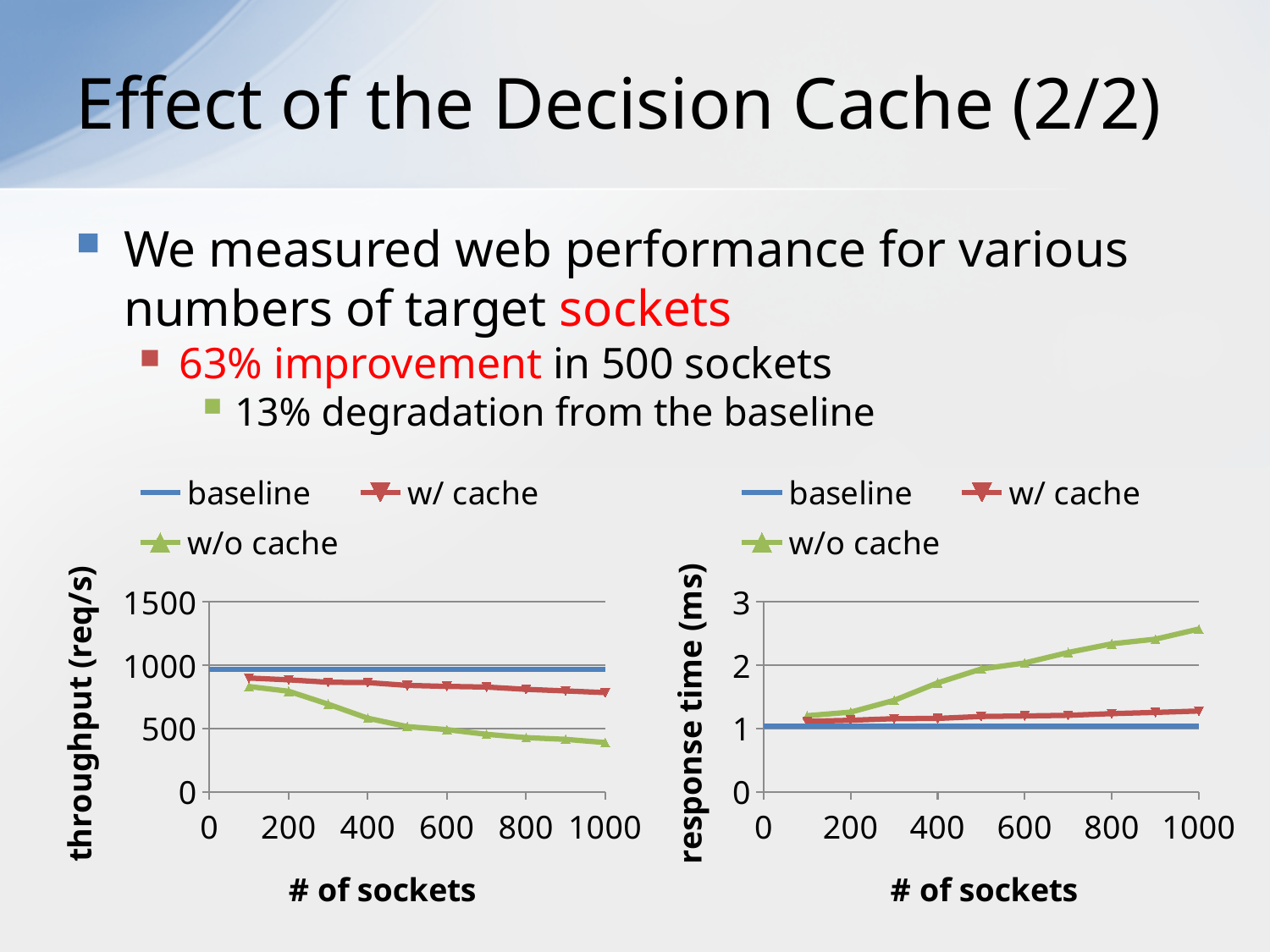
In the throughput (req/s) chart on the left, which series has the higher value at 1000 sockets, w/ cache or w/o cache? w/ cache In the throughput (req/s) chart on the left, is the w/o cache value at 1000 sockets greater or less than 500? less In the response time (ms) chart on the right, which series has the higher value at 800 sockets, w/o cache or baseline? w/o cache What kind of chart is the throughput (req/s) chart on the left? line chart In the throughput (req/s) chart on the left, is the w/ cache value at 1000 sockets greater or less than 500? greater In the response time (ms) chart on the right, is the w/ cache value at 1000 sockets greater or less than 2? less In the response time (ms) chart on the right, does the w/o cache series rise or fall as the number of sockets increases? rise In the throughput (req/s) chart on the left, does the w/o cache series rise or fall as the number of sockets increases? fall What is the x-axis title of the throughput (req/s) chart on the left? # of sockets How many series does the legend of the response time (ms) chart on the right list? 3 In the response time (ms) chart on the right, which series is drawn as a flat blue line? baseline